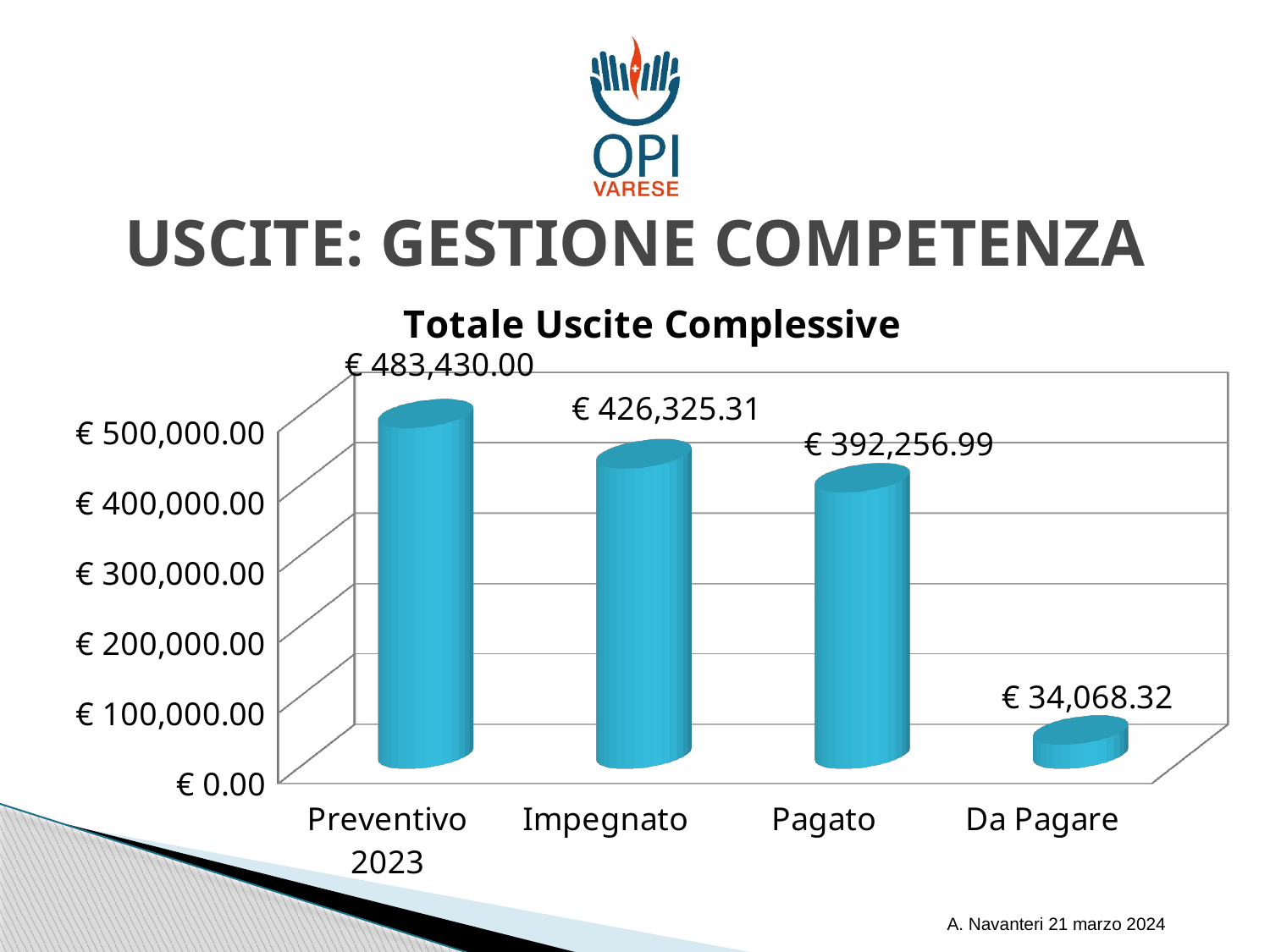
What is the value for Pagato? € 392,256.99 Which is larger, Pagato or Da Pagare? Pagato How many categories are shown on the x axis? 4 What is the value for Preventivo 2023? € 483,430.00 Which category has the lowest value? Da Pagare What is the value for Impegnato? € 426,325.31 What is the difference between Impegnato and Pagato? € 34,068.32 What is the difference between Preventivo 2023 and Impegnato? € 57,104.69 What kind of chart is this? Bar chart Which category has the highest value? Preventivo 2023 What is the title of the chart? Totale Uscite Complessive What is the value for Da Pagare? € 34,068.32